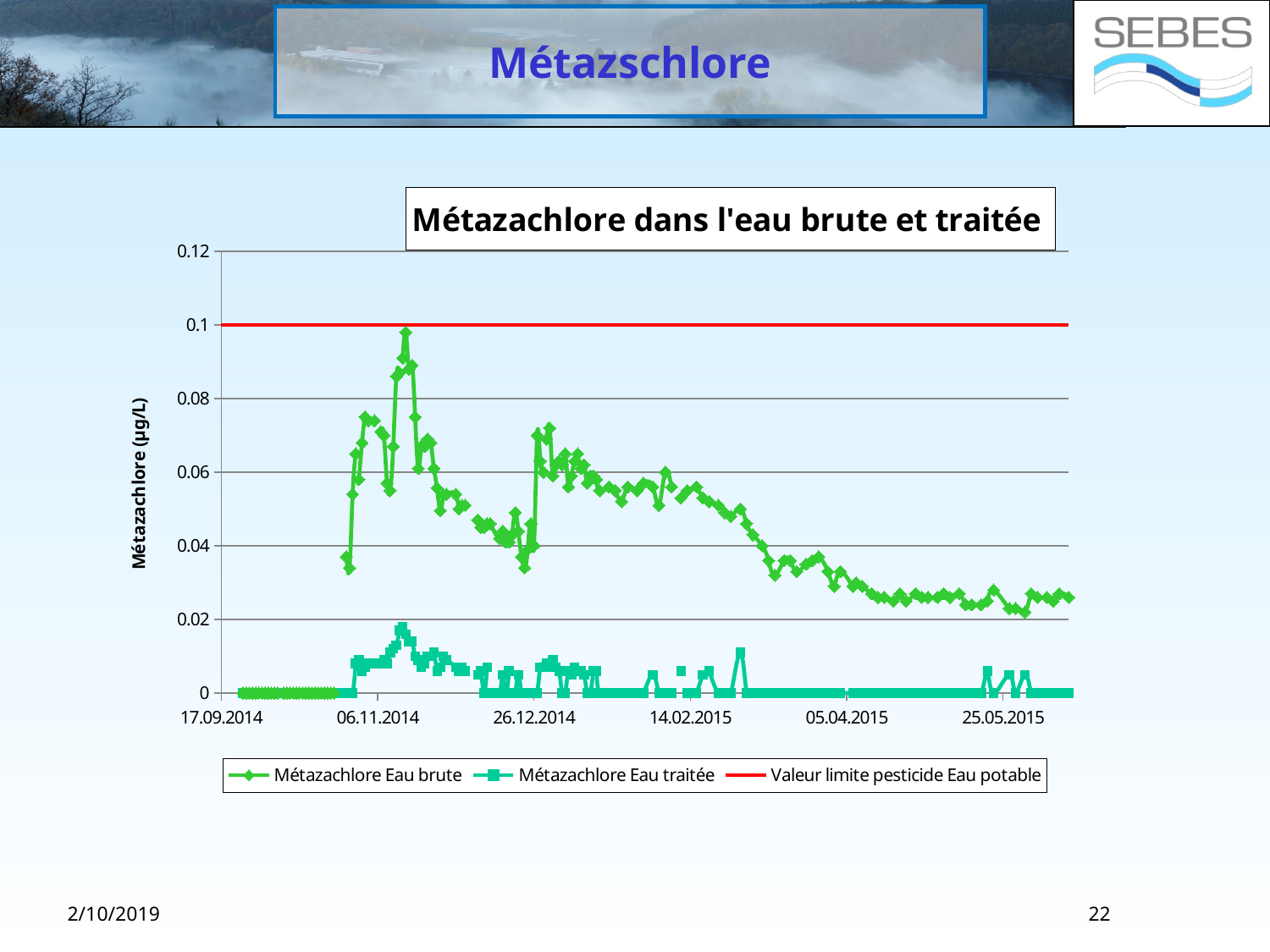
Does the 'Métazachlore Eau brute' series rise or fall between 14.02.2015 and 25.05.2015? fall What is the label of the y axis? Métazachlore (µg/L) What is the first date shown on the x axis? 17.09.2014 Is the value of 'Métazachlore Eau brute' around 14.02.2015 greater or less than 0.04? greater What is the title of the chart? Métazachlore dans l'eau brute et traitée What type of chart is shown on the slide? line chart How many series does the chart legend list? 3 At what value does the red 'Valeur limite pesticide Eau potable' line sit? 0.1 Is the value of 'Métazachlore Eau brute' around 25.05.2015 greater or less than 0.04? less Which series has higher values overall, 'Métazachlore Eau brute' or 'Métazachlore Eau traitée'? Métazachlore Eau brute